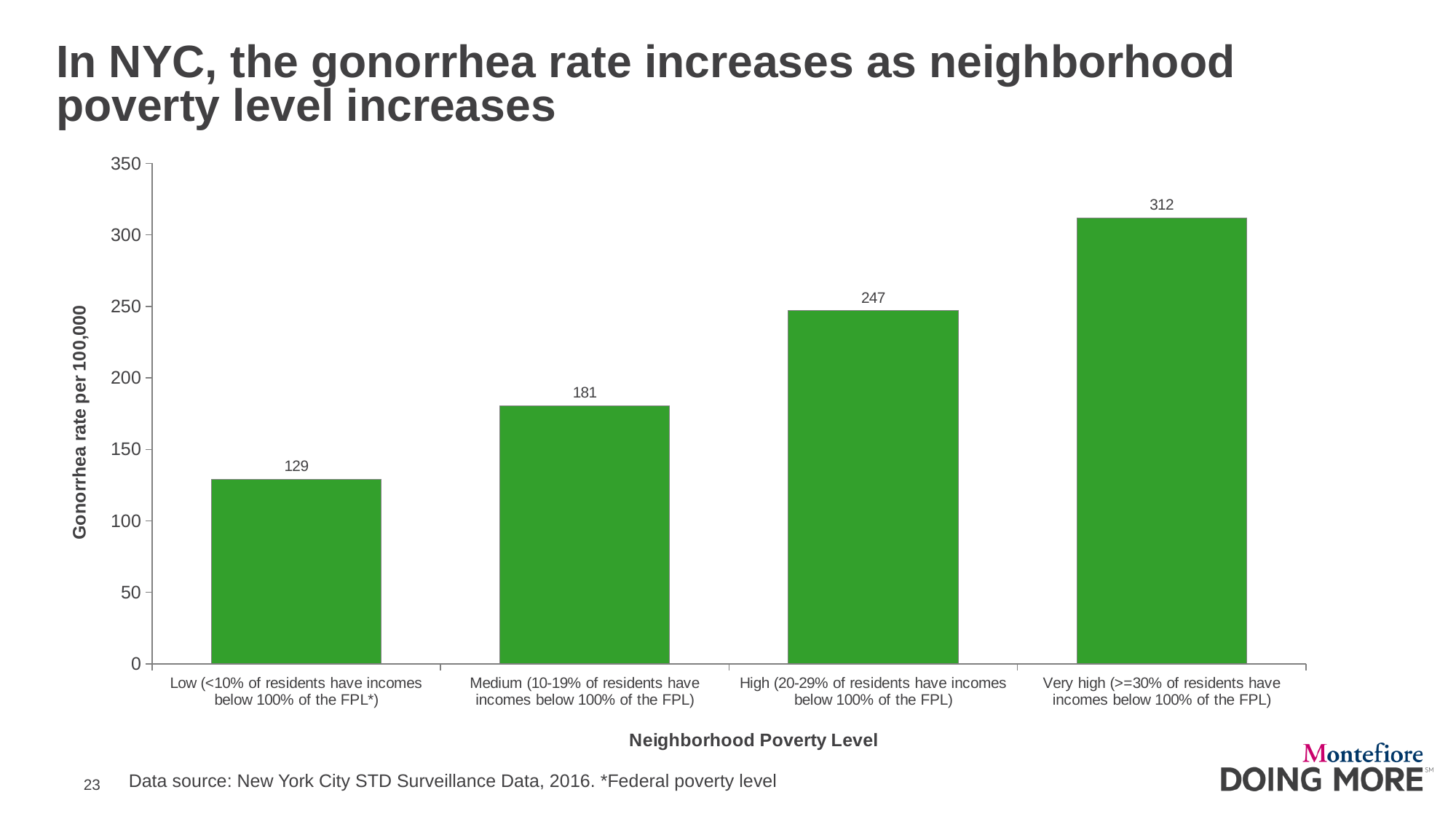
Do the gonorrhea rates rise or fall as neighborhood poverty level increases from Low to Very high? Rise What is the gonorrhea rate per 100,000 for the Medium neighborhood poverty level? 181 Which has a higher gonorrhea rate, the Medium or the High poverty level? High What is the difference in gonorrhea rate between the Very high and Low poverty levels? 183 What is the gonorrhea rate per 100,000 for the Low neighborhood poverty level? 129 What kind of chart is shown on the slide? Bar chart What is the difference in gonorrhea rate between the High and Medium poverty levels? 66 How many neighborhood poverty level categories are shown in the chart? 4 What is the gonorrhea rate per 100,000 for the Very high neighborhood poverty level? 312 Which neighborhood poverty level has the lowest gonorrhea rate? Low Which neighborhood poverty level has the highest gonorrhea rate? Very high What is the gonorrhea rate per 100,000 for the High neighborhood poverty level? 247